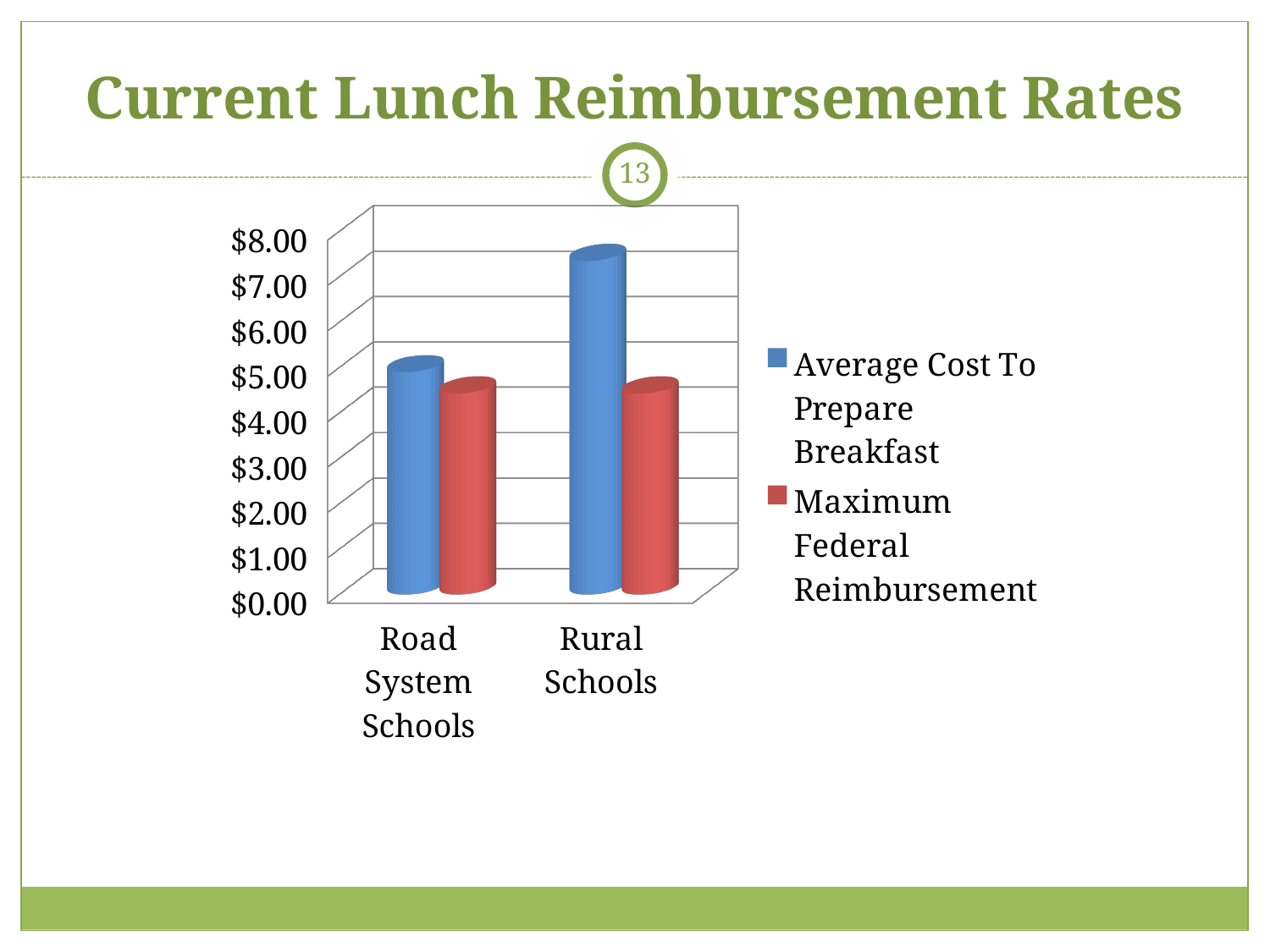
Is the Average Cost To Prepare Breakfast for Road System Schools greater or less than $4.00? greater Which category has the lowest Average Cost To Prepare Breakfast? Road System Schools How many categories are shown on the x axis of the chart? 2 For Rural Schools, which is larger: Average Cost To Prepare Breakfast or Maximum Federal Reimbursement? Average Cost To Prepare Breakfast Is the Average Cost To Prepare Breakfast for Rural Schools greater or less than $7.00? greater Which category has the highest Average Cost To Prepare Breakfast? Rural Schools What kind of chart is shown on the slide? bar chart How many series does the chart's legend list? 2 Is the Maximum Federal Reimbursement for Rural Schools greater or less than $5.00? less What is the title of the slide containing the chart? Current Lunch Reimbursement Rates Which colour represents Maximum Federal Reimbursement in the chart's legend? red Which is larger: the Average Cost To Prepare Breakfast for Rural Schools or for Road System Schools? Rural Schools